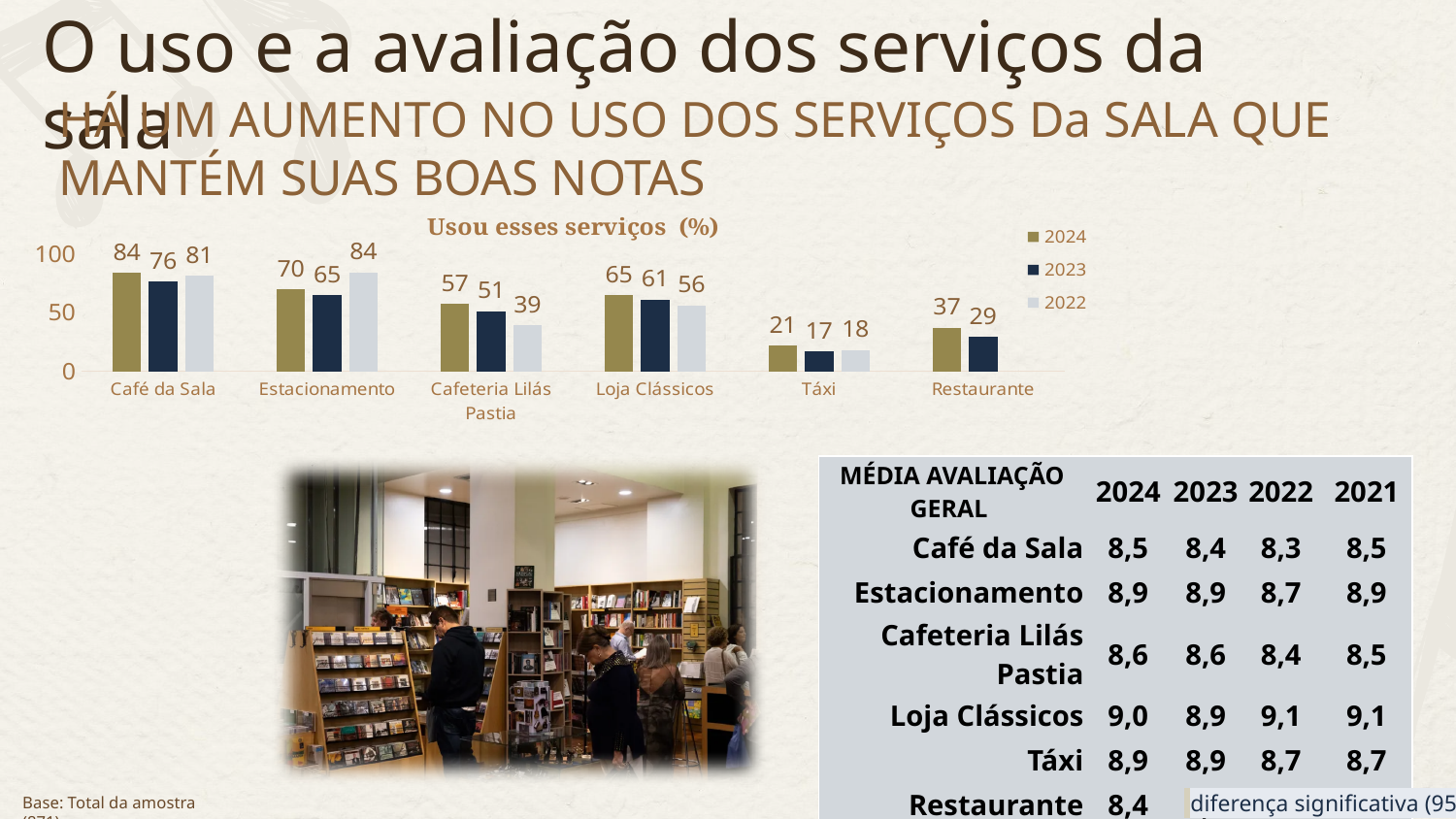
In the 'Usou esses serviços (%)' chart, what is the 2023 value for Restaurante? 29 What is the 2024 value for Café da Sala in the 'Usou esses serviços (%)' chart? 84 What is the difference between the 2024 and 2022 values for Cafeteria Lilás Pastia in the 'Usou esses serviços (%)' chart? 18 Which category has the highest 2023 value in the 'Usou esses serviços (%)' chart? Café da Sala How many series does the legend of the 'Usou esses serviços (%)' chart list? 3 How many categories are shown on the x axis of the 'Usou esses serviços (%)' chart? 6 In the 'Usou esses serviços (%)' chart, is the 2024 value for Loja Clássicos or the 2024 value for Estacionamento larger? Estacionamento Which category has the lowest 2024 value in the 'Usou esses serviços (%)' chart? Táxi What is the 2023 value for Cafeteria Lilás Pastia in the 'Usou esses serviços (%)' chart? 51 What is the 2022 value for Estacionamento in the 'Usou esses serviços (%)' chart? 84 What kind of chart is 'Usou esses serviços (%)'? Bar chart Which years are listed in the legend of the 'Usou esses serviços (%)' chart? 2024, 2023, 2022